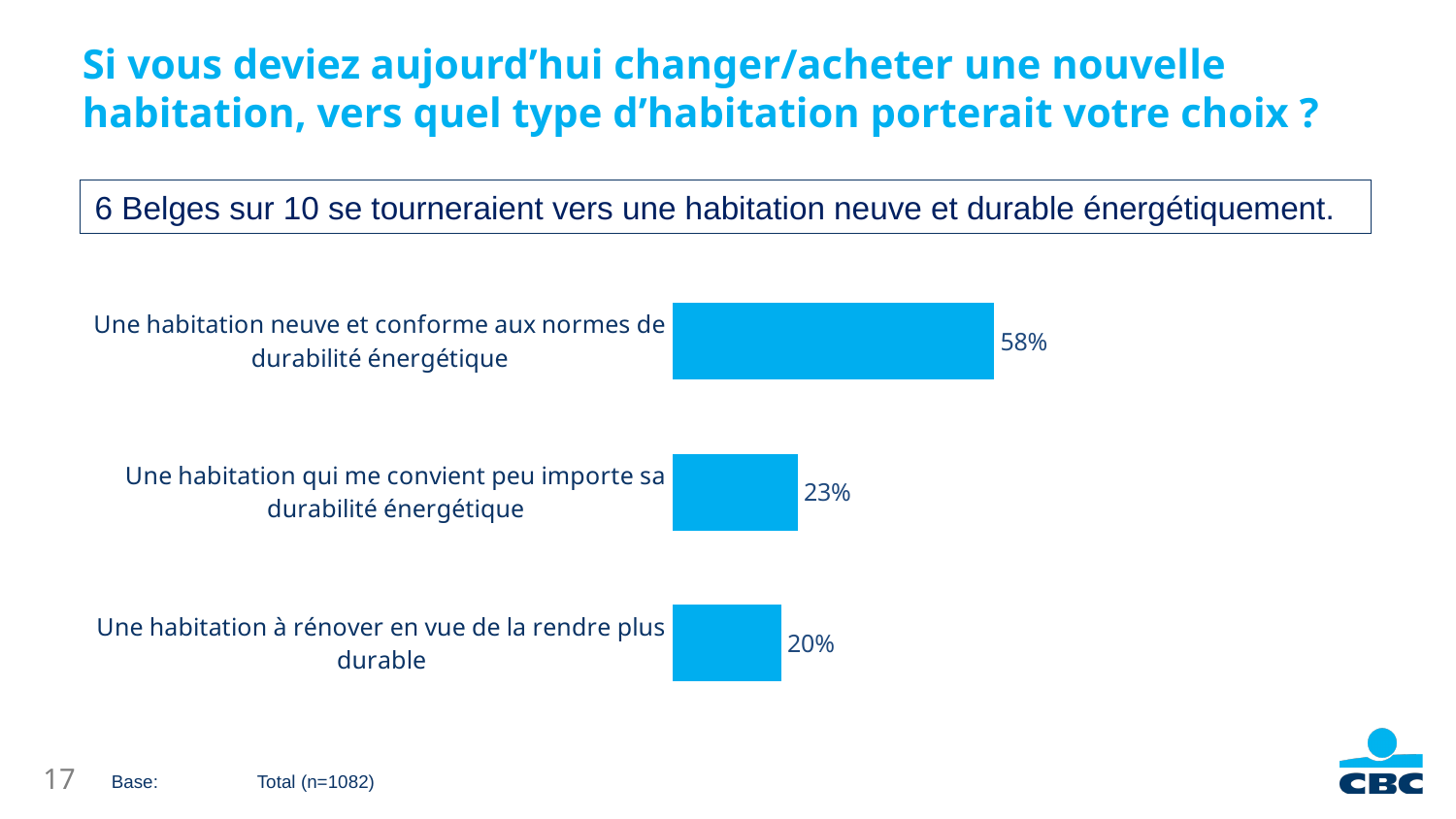
What is the difference in percentage points between "Une habitation qui me convient peu importe sa durabilité énergétique" and "Une habitation à rénover en vue de la rendre plus durable"? 3 How many housing options are shown in the chart? 3 What colour are the bars in the chart? Blue Which housing option has the highest percentage? Une habitation neuve et conforme aux normes de durabilité énergétique What percentage of respondents would choose "Une habitation neuve et conforme aux normes de durabilité énergétique"? 58% What is the sample size (base) stated at the bottom of the slide? Total (n=1082) What type of chart is shown on the slide? Bar chart What is the difference in percentage points between "Une habitation neuve et conforme aux normes de durabilité énergétique" and "Une habitation qui me convient peu importe sa durabilité énergétique"? 35 What is the value shown for "Une habitation qui me convient peu importe sa durabilité énergétique"? 23% Which is larger: the value for "Une habitation qui me convient peu importe sa durabilité énergétique" or for "Une habitation à rénover en vue de la rendre plus durable"? Une habitation qui me convient peu importe sa durabilité énergétique What is the value shown for "Une habitation à rénover en vue de la rendre plus durable"? 20% Which housing option has the lowest percentage? Une habitation à rénover en vue de la rendre plus durable